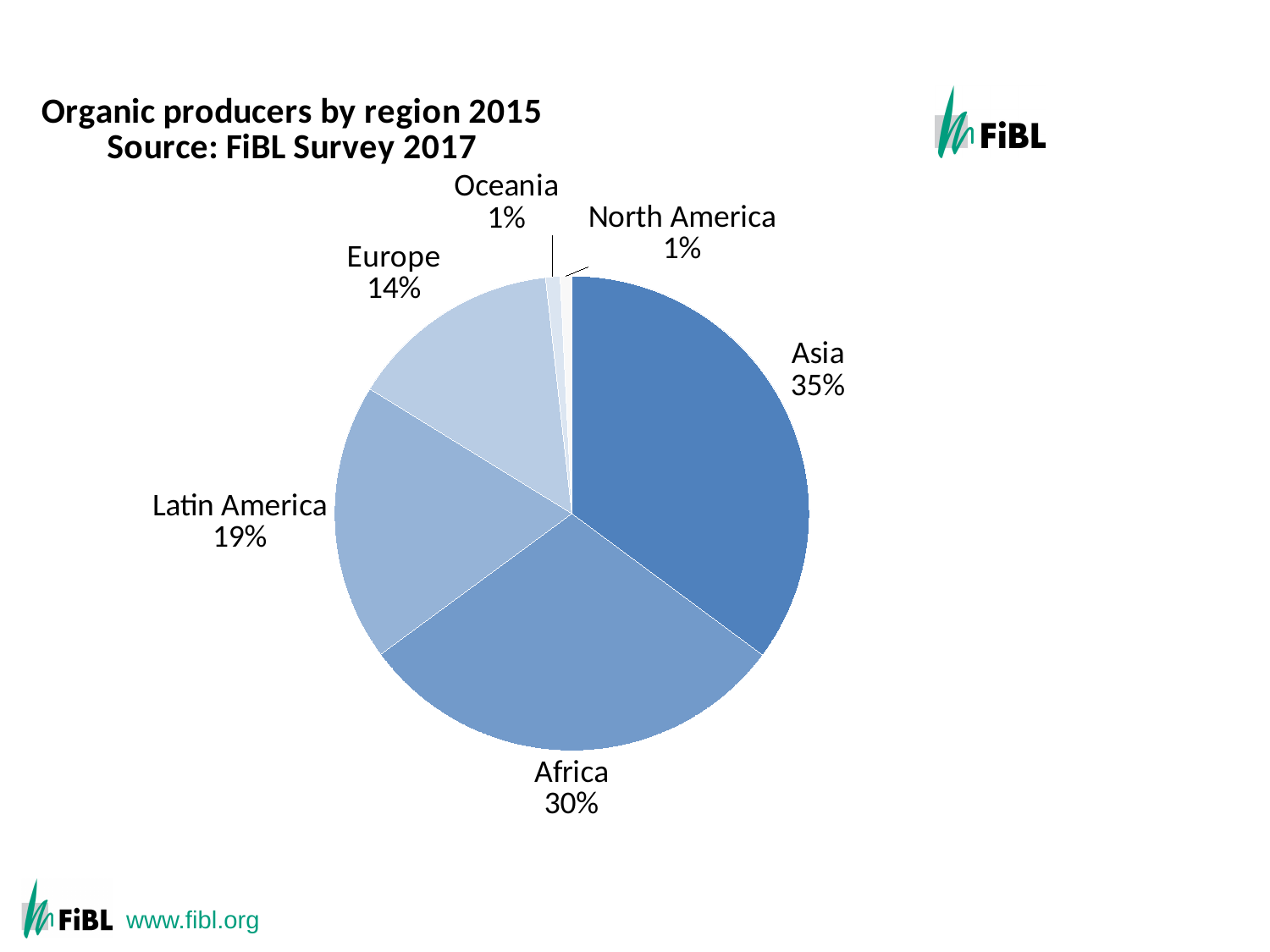
What share of organic producers is in Europe? 14% What is the difference in share between Latin America and Europe? 5% Which has a larger share, Africa or Latin America? Africa What is the difference in share between Asia and Africa? 5% What share of organic producers is in Asia? 35% What is the title of the chart? Organic producers by region 2015 What kind of chart is shown on the slide? pie chart What is the source given for the chart data? FiBL Survey 2017 Which region has the largest share of organic producers? Asia What share of organic producers is in Latin America? 19% How many regions are shown in the pie chart? 6